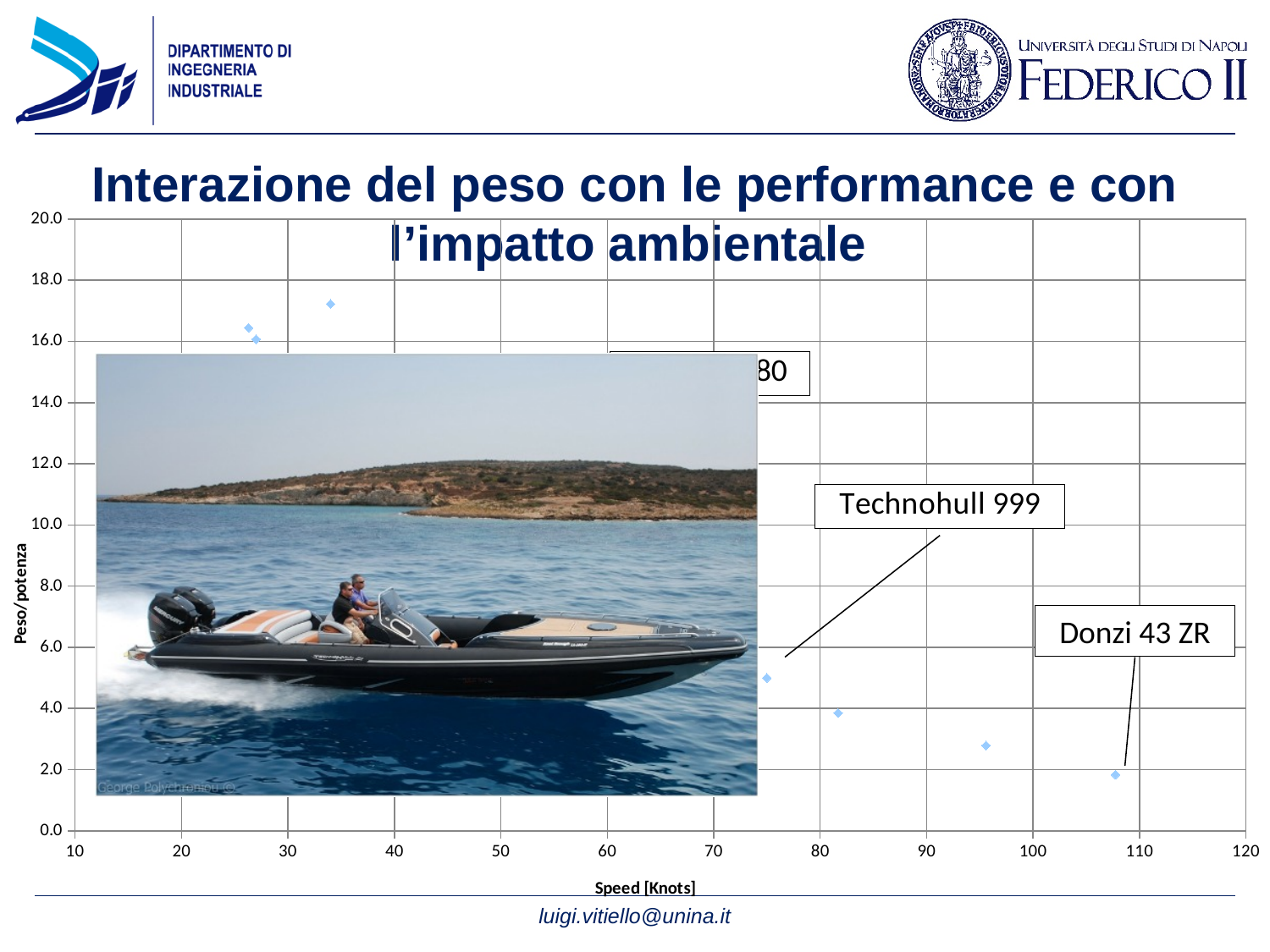
What is the title of the x axis of the chart? Speed [Knots] Is the Peso/potenza value of the point at about 34 knots greater or less than 16.0? greater Is the Peso/potenza value for Technohull 999 greater or less than 8.0? less Which of the two labelled boats, Technohull 999 or Donzi 43 ZR, has the higher speed? Donzi 43 ZR Is the speed of Technohull 999 greater or less than 70 knots? greater Do the Peso/potenza values rise or fall as speed increases along the x axis? fall What kind of chart is shown on the slide? scatter chart What is the title of the y axis of the chart? Peso/potenza Of the labelled boats, which has the lowest Peso/potenza value? Donzi 43 ZR Which of the two labelled boats, Technohull 999 or Donzi 43 ZR, has the higher Peso/potenza value? Technohull 999